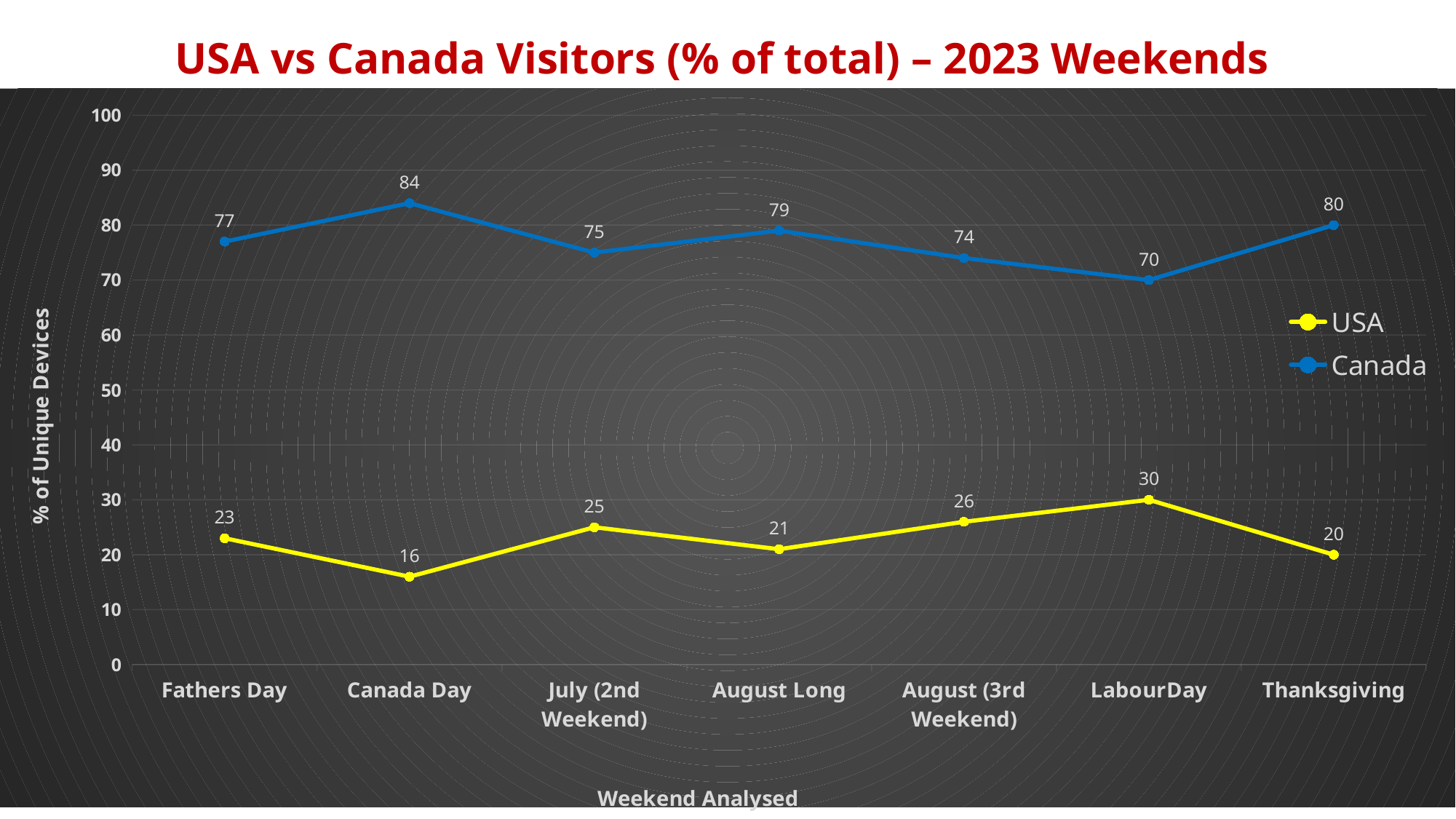
What is the Canada value for Canada Day? 84 How many series does the legend list? 2 What is the label of the y axis? % of Unique Devices Which weekend has the lowest USA value? Canada Day What is the USA value for LabourDay? 30 What is the difference between the Canada and USA values for Thanksgiving? 60 Which is larger, the USA value for Fathers Day or the USA value for July (2nd Weekend)? July (2nd Weekend) Which weekend has the highest Canada value? Canada Day Which weekend has the lowest Canada value? LabourDay What is the USA value for August Long? 21 What kind of chart is shown? Line chart How many weekends are plotted on the x axis? 7